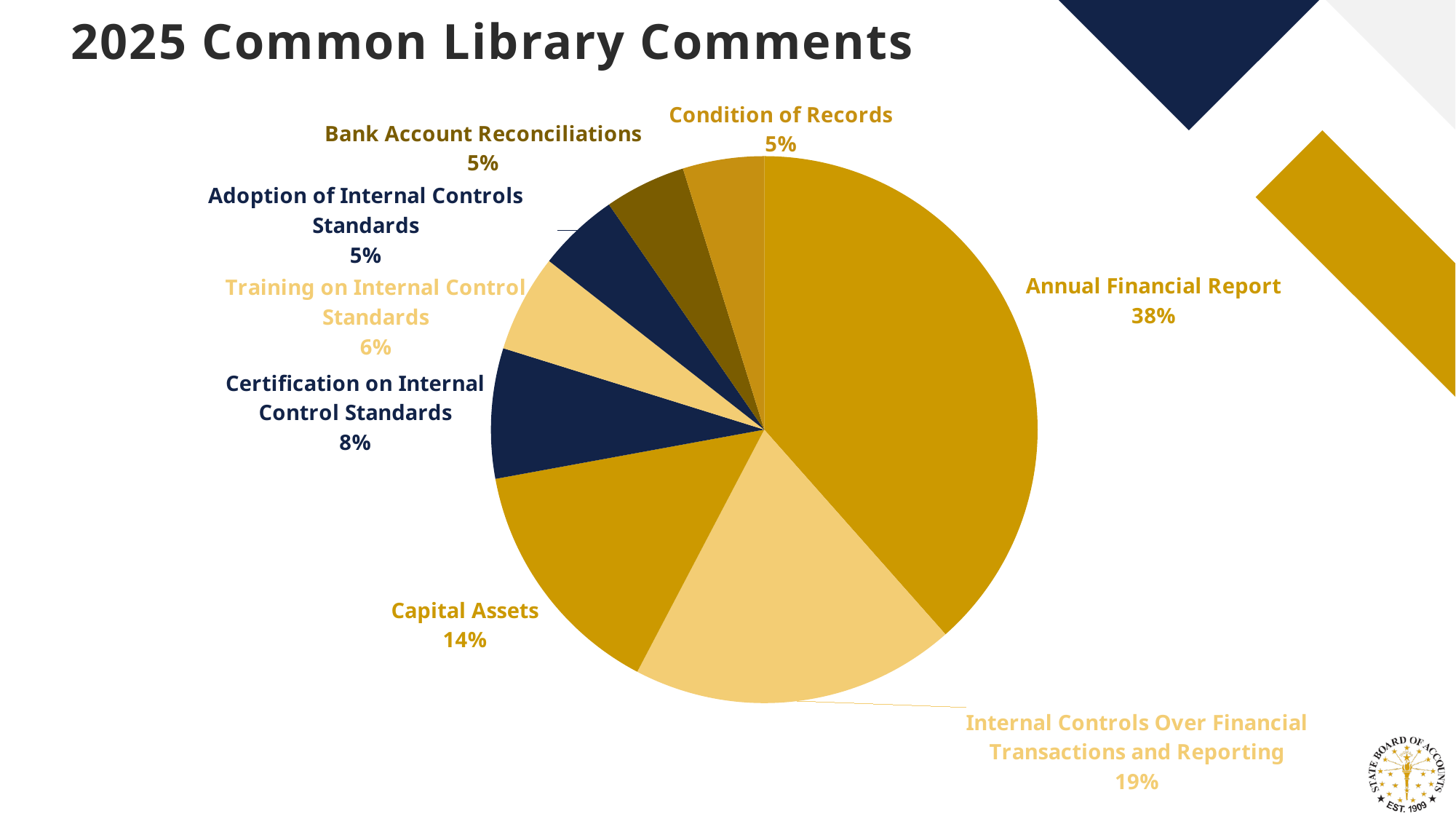
What is the difference between Capital Assets and Training on Internal Control Standards? 8% What is the difference between Annual Financial Report and Internal Controls Over Financial Transactions and Reporting? 19% How many slices does the pie chart have? 8 Which category has the largest slice? Annual Financial Report What is the title of the chart? 2025 Common Library Comments What share of the pie is Annual Financial Report? 38% What is the value for Training on Internal Control Standards? 6% Which is larger, Capital Assets or Certification on Internal Control Standards? Capital Assets What is the value for Certification on Internal Control Standards? 8% What is the value for Capital Assets? 14% What share of the pie is Internal Controls Over Financial Transactions and Reporting? 19% What kind of chart is shown on the slide? pie chart